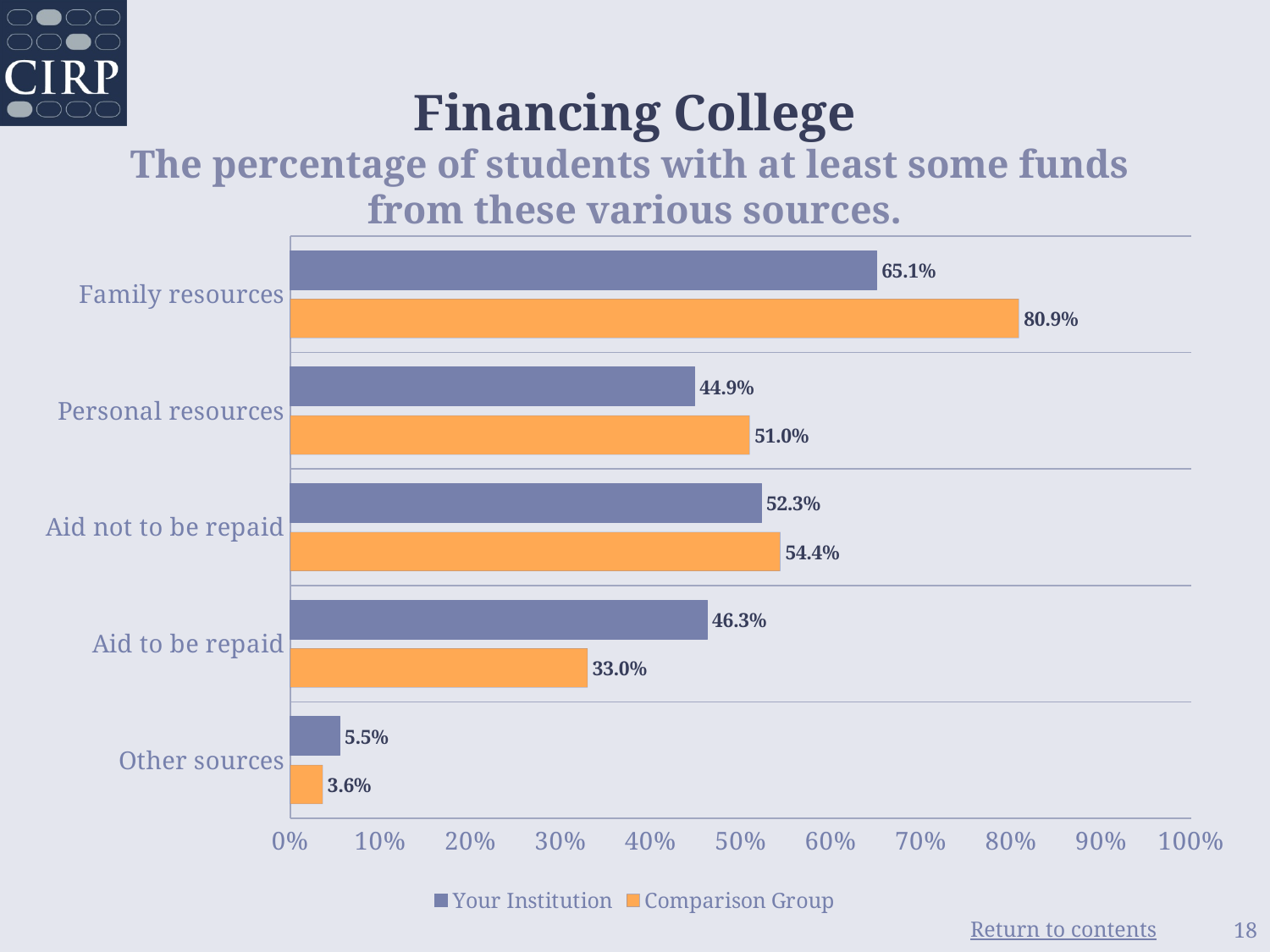
What is the difference between Your Institution and the Comparison Group for Aid to be repaid? 13.3% What is the value for Family resources for Your Institution? 65.1% Which category has the highest value for the Comparison Group? Family resources How many categories are shown on the chart? 5 What is the difference between the Comparison Group and Your Institution values for Family resources? 15.8% What kind of chart is shown on the slide? Bar chart For Personal resources, which is larger: Your Institution or the Comparison Group? Comparison Group What is the value for Other sources for Your Institution? 5.5% What is the value for Aid to be repaid for the Comparison Group? 33.0% Which category has the lowest value for Your Institution? Other sources Is the Comparison Group value for Family resources greater or less than 70%? greater How many series does the legend list? 2